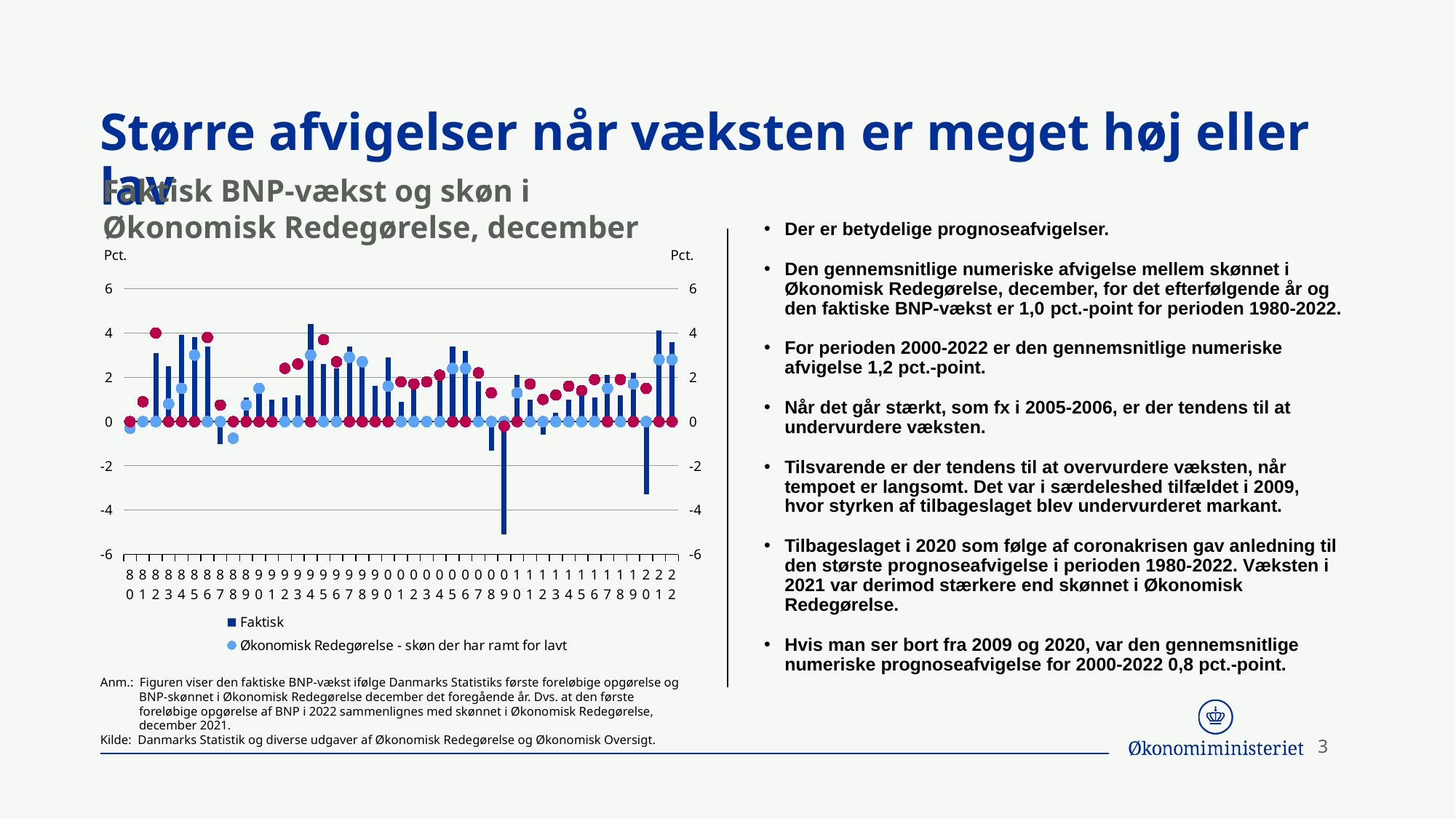
Is the Faktisk value for 2020 greater or less than -2? less How many series does the legend list? 2 Which year has the larger Faktisk value, 2009 or 2020? 2020 Is the Faktisk value for 2008 greater or less than 0? less What unit is shown on the vertical axes of the chart? Pct. What kind of chart is shown on the slide? combination bar and line chart (bars with dot markers) Which year has the lowest Faktisk bar in the chart? 2009 What is the title of the chart? Faktisk BNP-vækst og skøn i Økonomisk Redegørelse, december How many years are plotted along the x axis of the chart? 43 Which year has the larger Faktisk value, 1994 or 2008? 1994 Is the Faktisk value for 2009 greater or less than -4? less